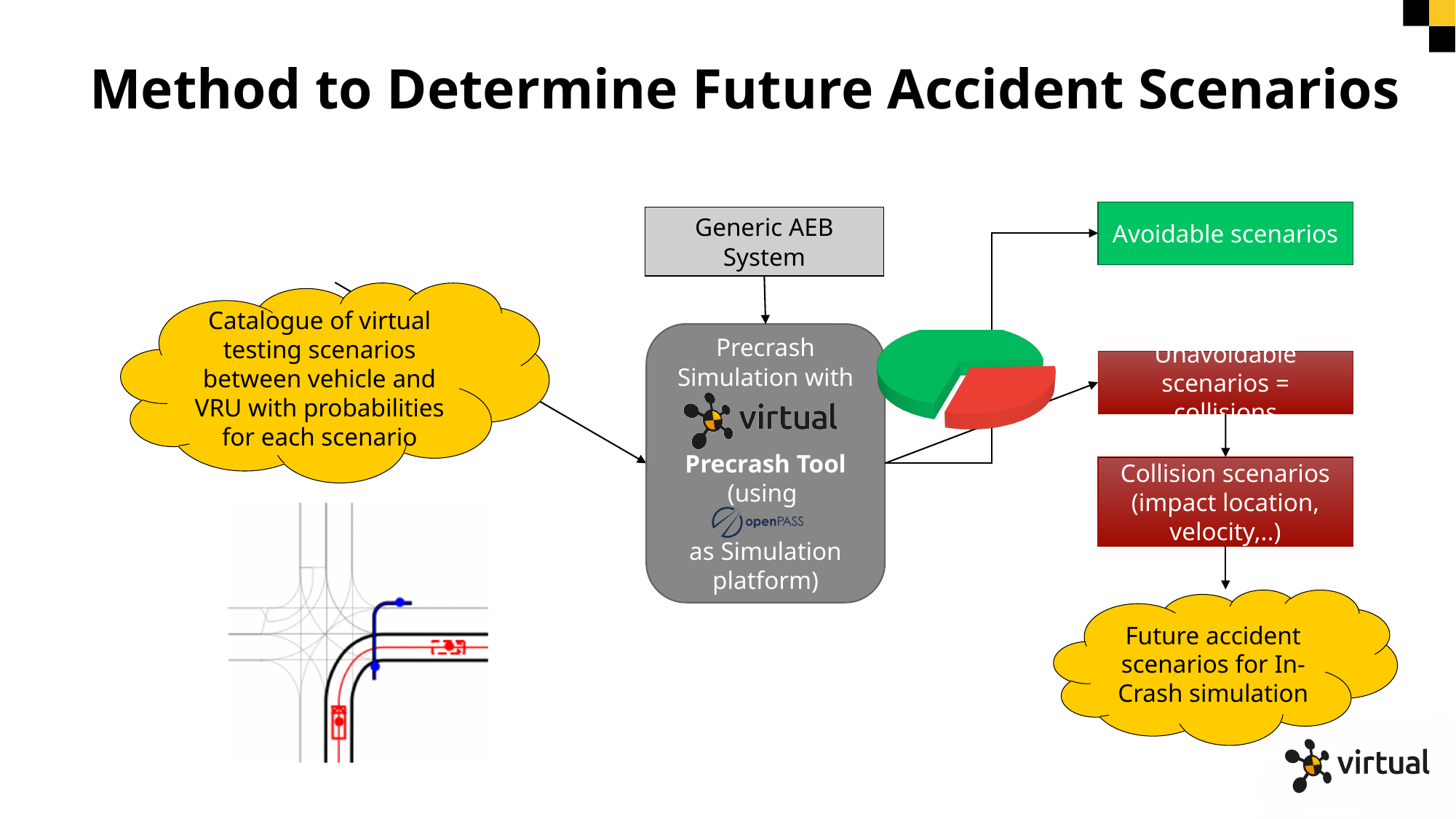
Which slice of the pie chart is the smallest, the green one or the red one? red In the pie chart, is the green slice larger or smaller than the red slice? larger Which slice of the pie chart is the largest, the green one or the red one? green What two colours are used for the slices of the pie chart? green and red What kind of chart is shown in the middle of the slide, next to the Precrash Tool box? pie chart How many slices does the pie chart on the slide have? 2 Which slice of the pie chart is pulled out (exploded) from the rest of the pie? the red slice